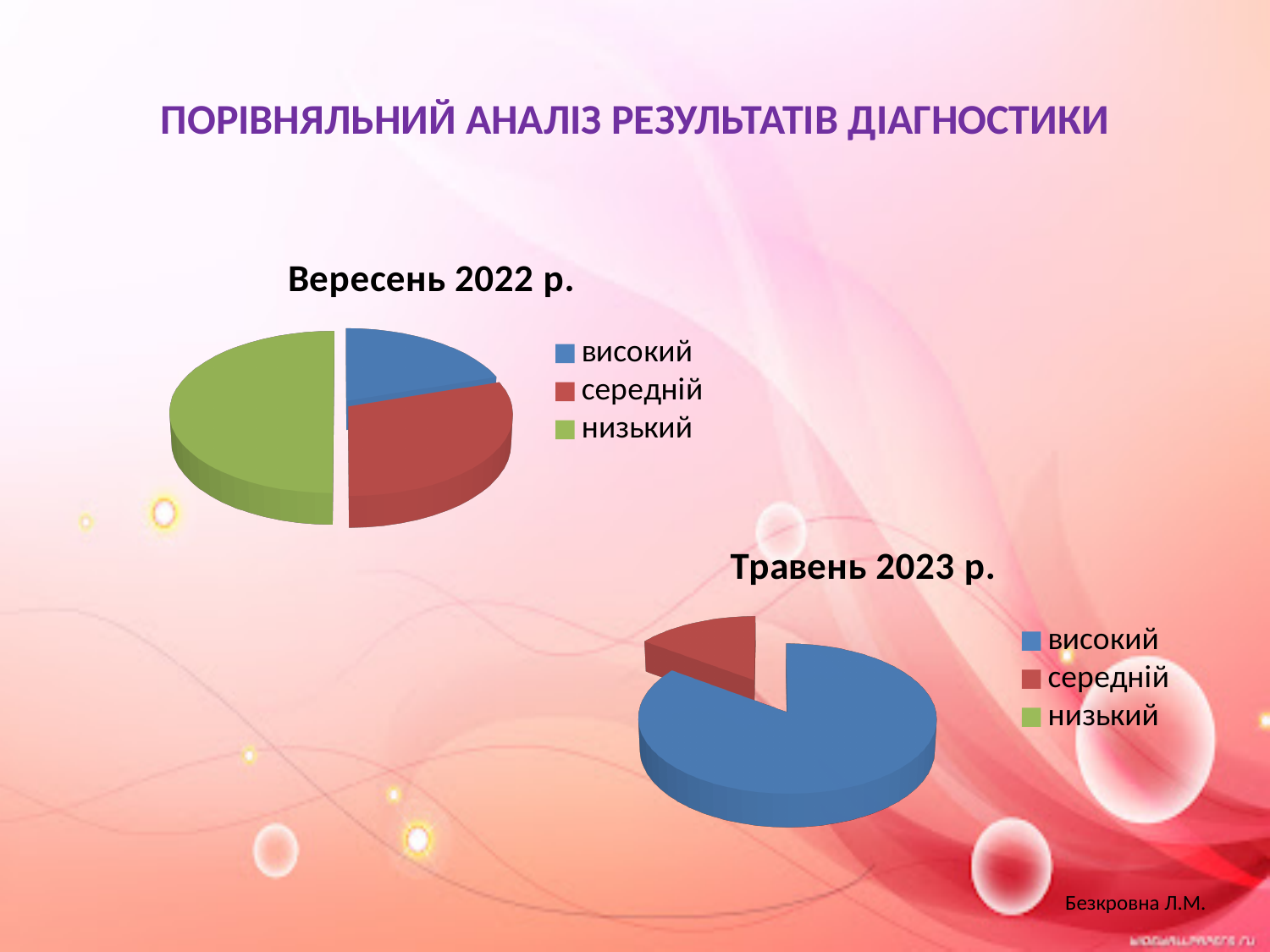
What kind of chart is the "Вересень 2022 р." chart? pie chart What is the title of the chart in the upper left of the slide? Вересень 2022 р. In the "Вересень 2022 р." chart, which category has the largest slice? низький How many entries does the legend of the "Вересень 2022 р." chart list? 3 What kind of chart is the "Травень 2023 р." chart? pie chart In the "Вересень 2022 р." chart, which colour represents середній in the legend? red In the "Вересень 2022 р." chart, which is larger: the slice for низький or the slice for високий? низький How many entries does the legend of the "Травень 2023 р." chart list? 3 In the "Вересень 2022 р." chart, which category has the smallest slice? високий In the "Травень 2023 р." chart, which category has the largest slice? високий In the "Травень 2023 р." chart, which is larger: the slice for високий or the slice for середній? високий How many slices are visible in the "Травень 2023 р." pie chart? 2